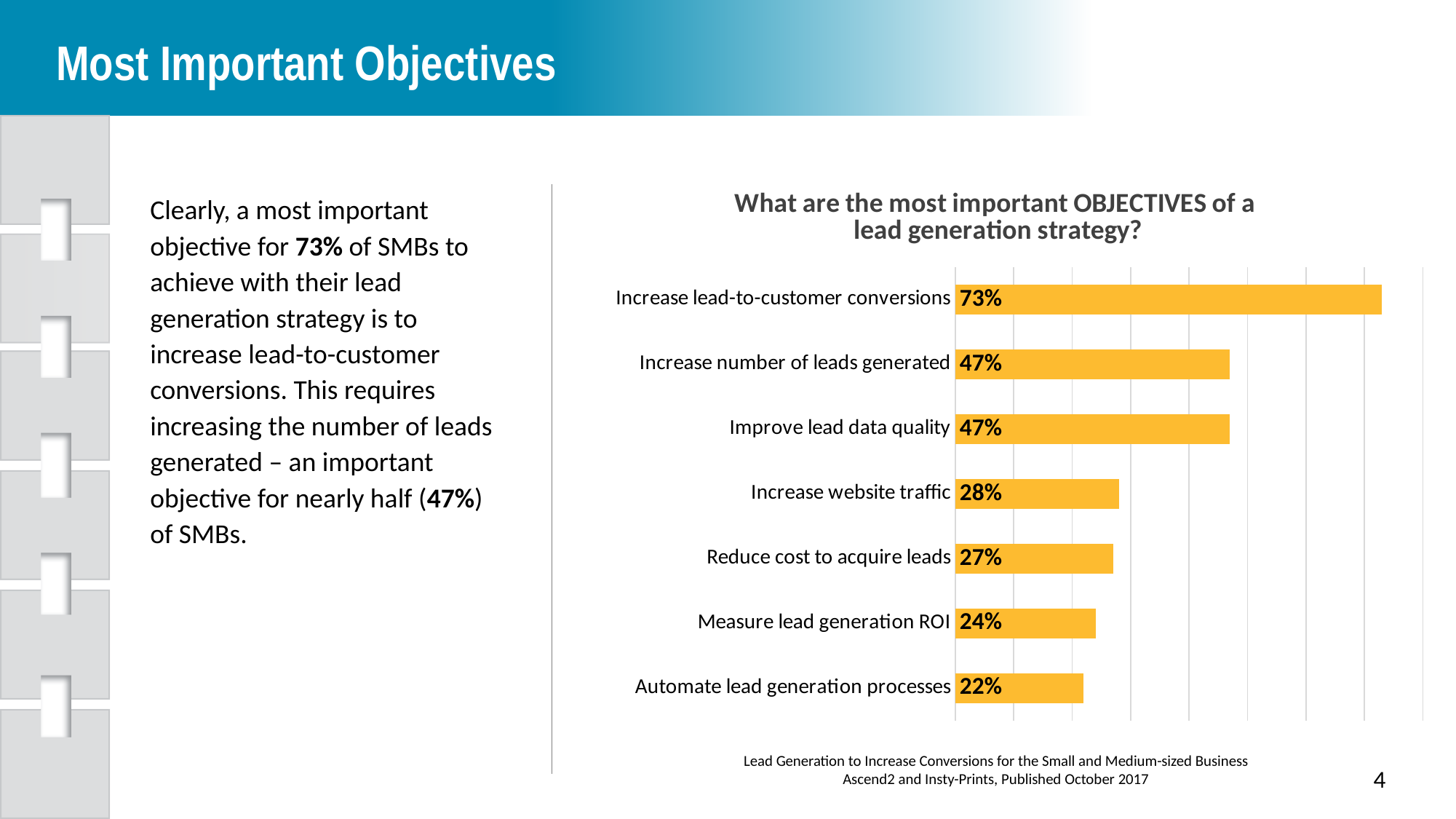
What is the value shown for 'Automate lead generation processes'? 22% What percentage of SMBs cite 'Increase lead-to-customer conversions' as a most important objective? 73% How many objectives are listed in the chart? 7 Which is larger: the value for 'Increase website traffic' or the value for 'Measure lead generation ROI'? Increase website traffic What type of chart is shown on the slide? Bar chart What is the difference between the values for 'Increase lead-to-customer conversions' and 'Increase number of leads generated'? 26% What is the title of the chart? What are the most important OBJECTIVES of a lead generation strategy? Which objective has the highest percentage? Increase lead-to-customer conversions Which objective has the lowest percentage? Automate lead generation processes What is the value shown for 'Increase website traffic'? 28% What is the value shown for 'Measure lead generation ROI'? 24% What is the difference between the values for 'Reduce cost to acquire leads' and 'Automate lead generation processes'? 5%